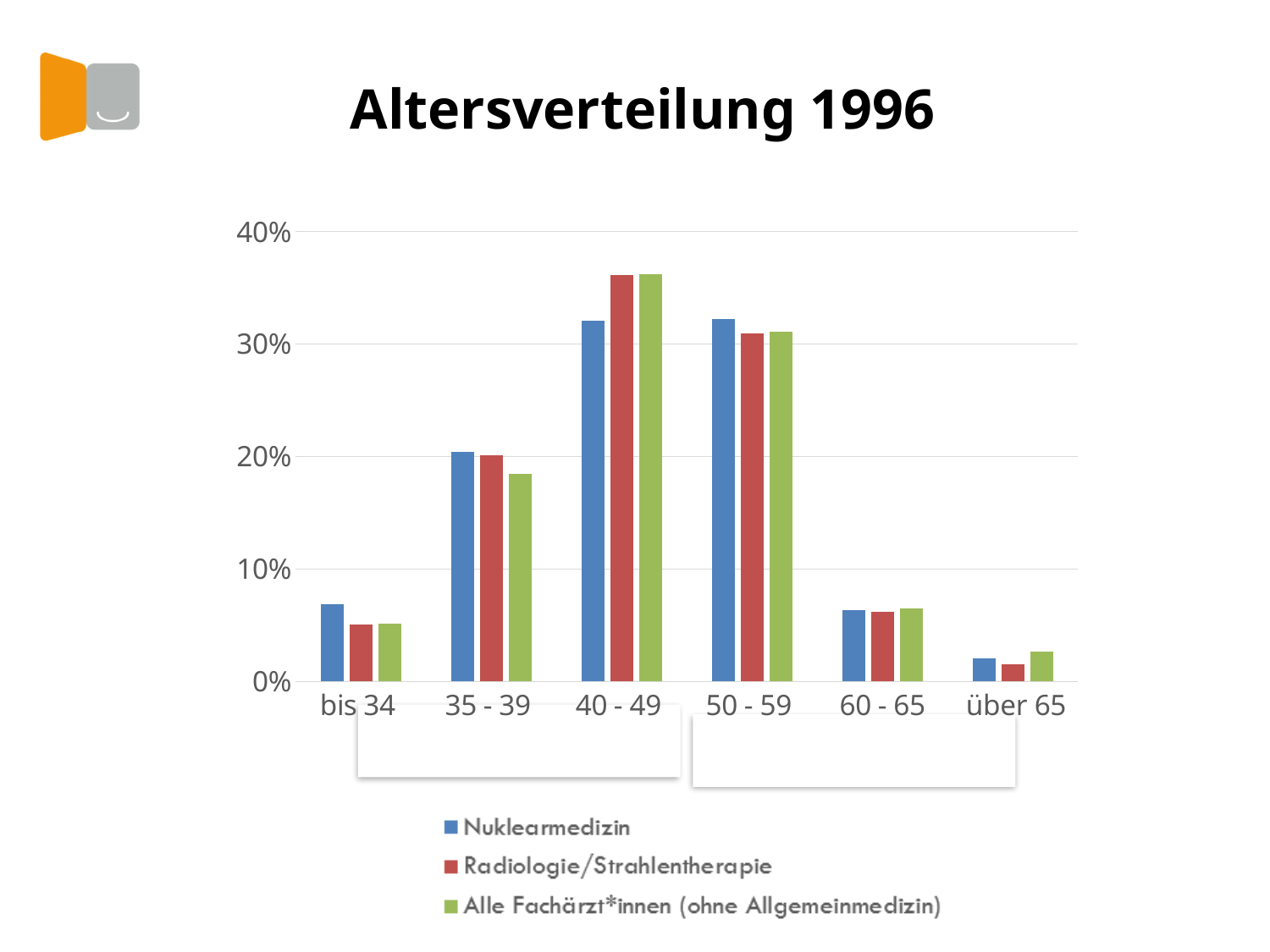
Is the value for Alle Fachärzt*innen (ohne Allgemeinmedizin) in the 35 - 39 category greater or less than 20%? less Is the value for Nuklearmedizin in the 40 - 49 category greater or less than 30%? greater Which age category has the highest value for Radiologie/Strahlentherapie? 40 - 49 What kind of chart is shown on the slide? bar chart Which age category has the lowest value for Nuklearmedizin? über 65 Is the value for Nuklearmedizin in the bis 34 category greater or less than 10%? less Do the Nuklearmedizin values rise or fall from the 50 - 59 category to the über 65 category? fall What is the title of the chart? Altersverteilung 1996 In the 40 - 49 category, which is larger: Nuklearmedizin or Radiologie/Strahlentherapie? Radiologie/Strahlentherapie How many series does the legend list? 3 In the bis 34 category, which is larger: Nuklearmedizin or Radiologie/Strahlentherapie? Nuklearmedizin How many age categories are shown on the x axis? 6